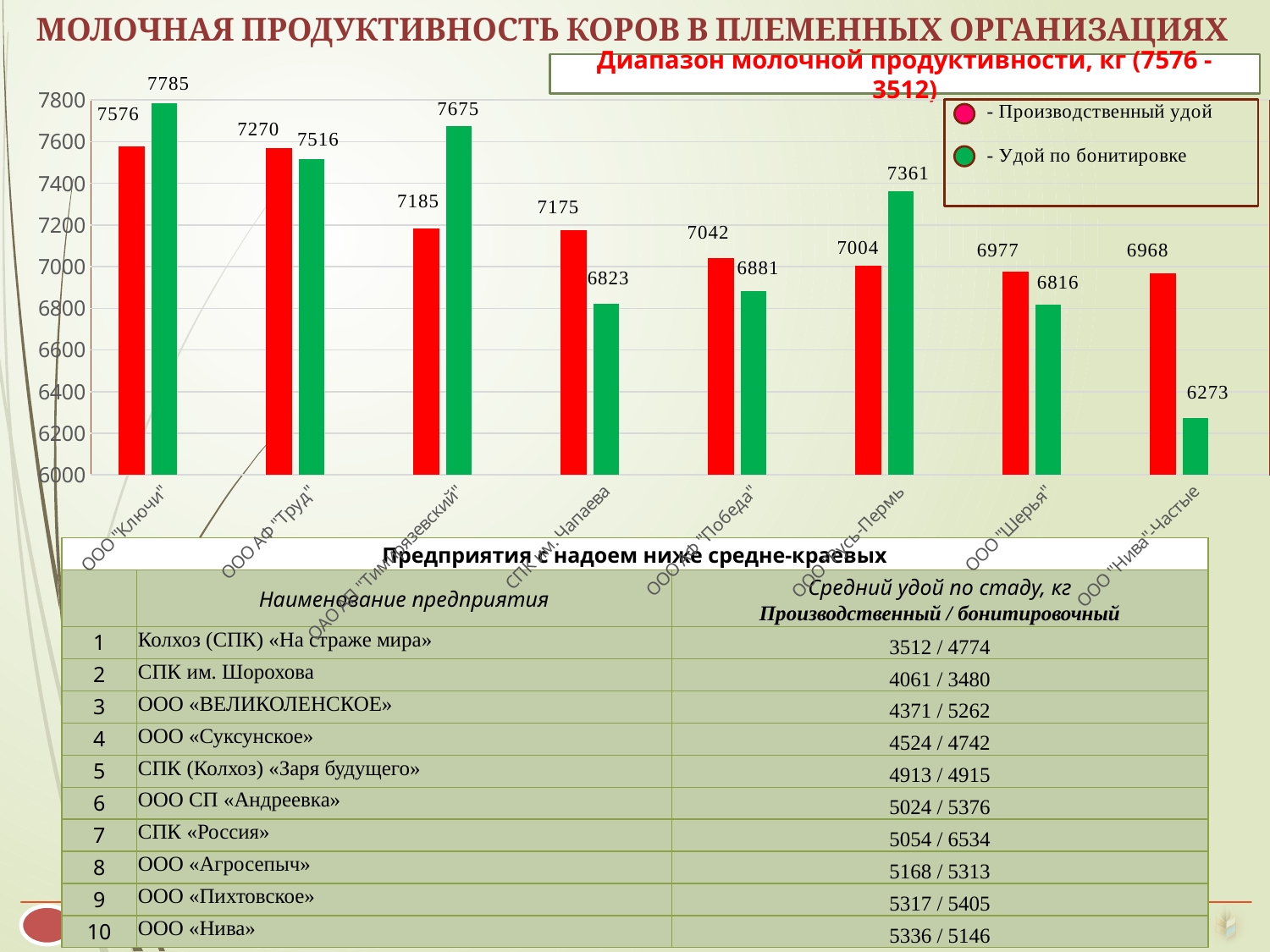
Which category has the highest Удой по бонитировке value? ООО "Ключи" Is the Удой по бонитировке value for ООО "Нива"-Частые greater or less than 6400? less What is the Удой по бонитировке value for СПК им. Чапаева? 6823 For ООО АФ "Победа", which is larger: Производственный удой or Удой по бонитировке? Производственный удой What is the Удой по бонитировке value for ООО "Ключи"? 7785 Which category has the lowest Удой по бонитировке value? ООО "Нива"-Частые How many series does the chart legend list? 2 What is the Производственный удой value for ООО "Шерья"? 6977 What type of chart is shown on the slide? bar chart How many categories are shown on the x axis of the chart? 8 What is the Производственный удой value for ООО "Ключи"? 7576